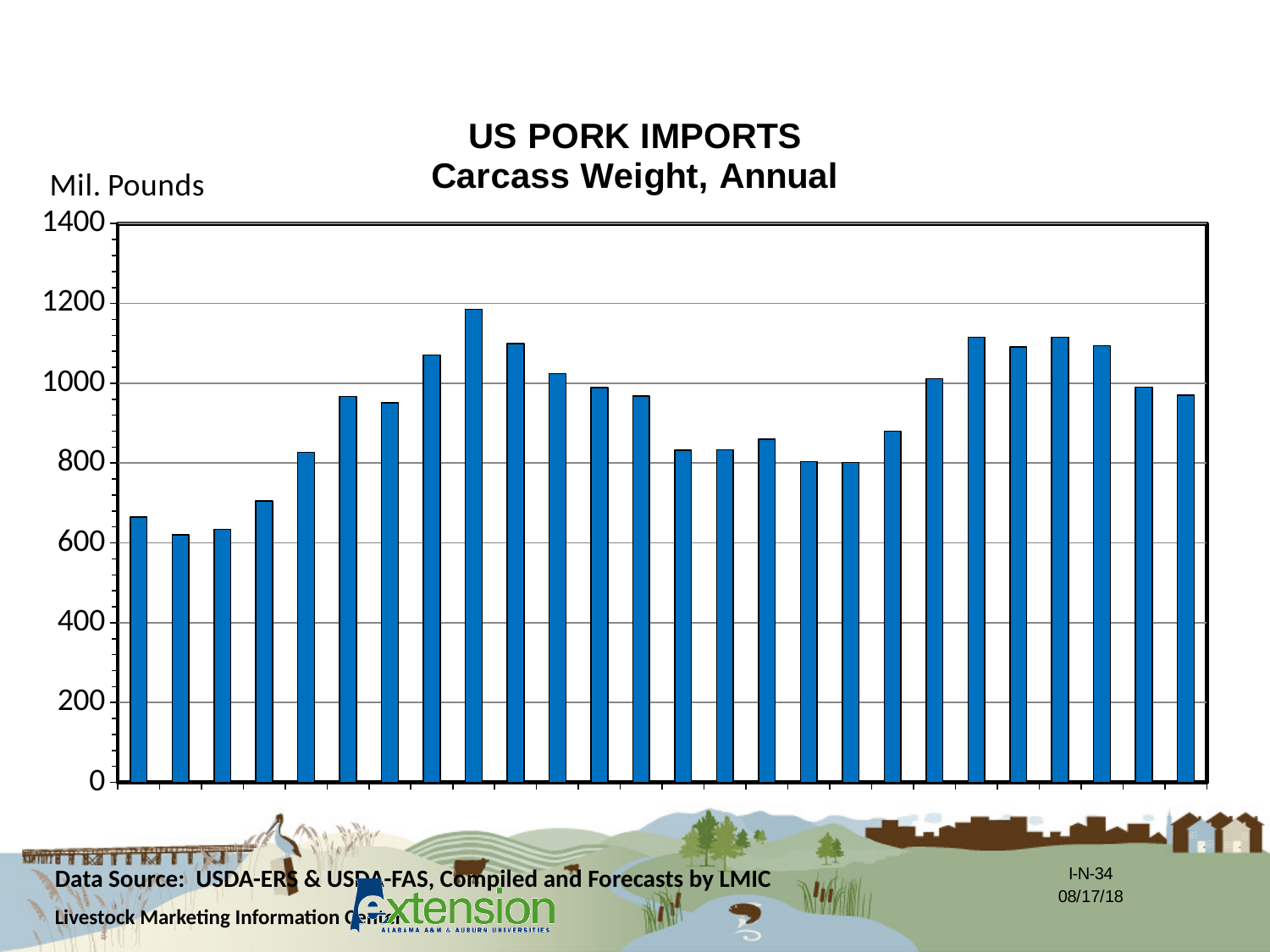
What kind of chart is shown on the slide? bar chart Is the tallest bar located in the left half or the right half of the chart? left half Is the value of the first (leftmost) bar greater or less than 600? greater How many bars are plotted in the chart? 26 Do the values generally rise or fall from the first bar to the last bar? rise What is the title of the chart? US PORK IMPORTS Carcass Weight, Annual Is the value of the last (rightmost) bar greater or less than 1000? less Is the value of the shortest bar greater or less than 800? less What unit is shown on the y axis of the chart? Mil. Pounds Which is larger, the first (leftmost) bar or the last (rightmost) bar? the last (rightmost) bar How many data series are plotted in the chart? 1